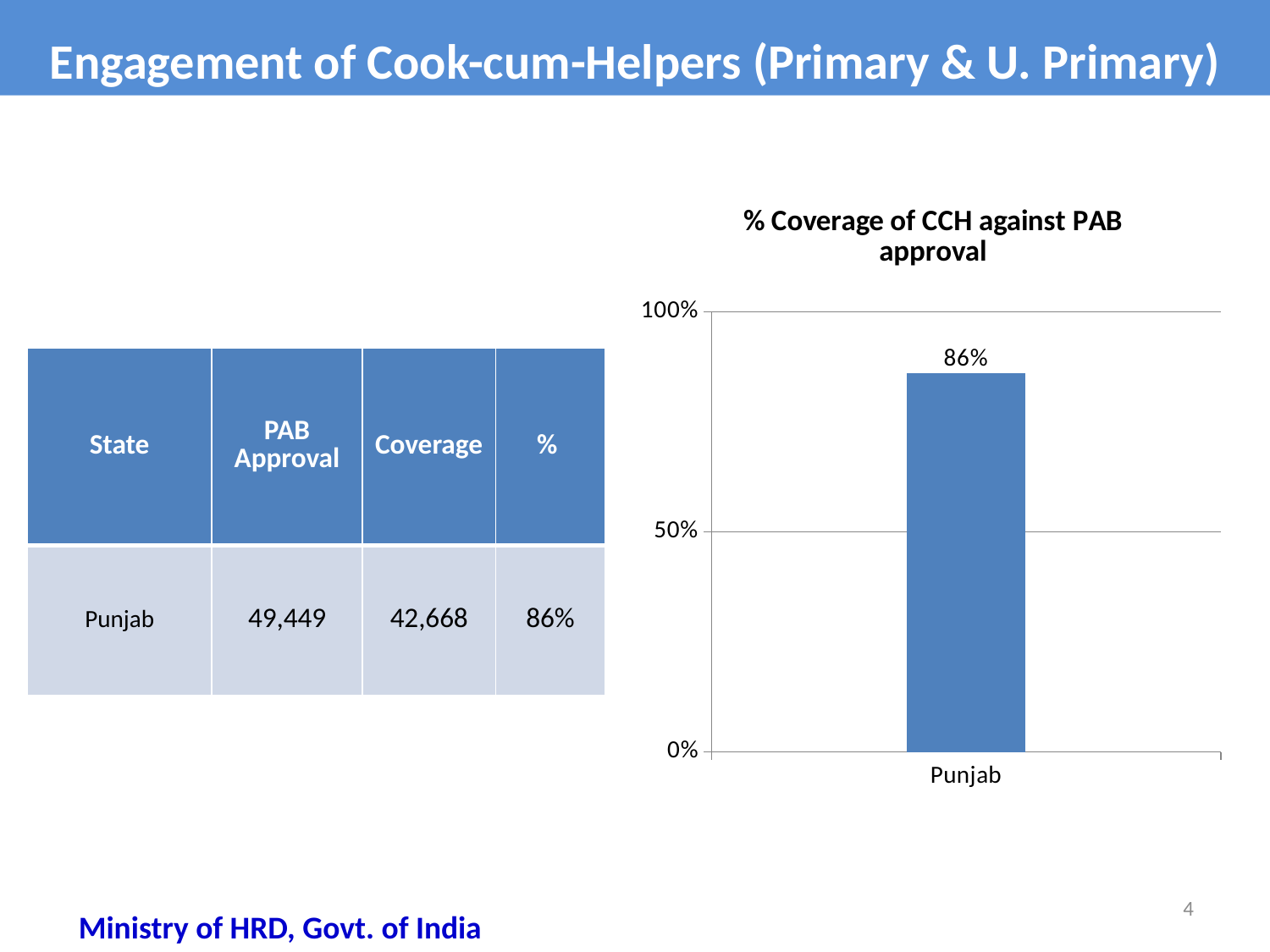
What kind of chart is shown on the slide? bar chart Is the value for Punjab greater or less than 50%? greater Which state is shown on the x axis of the chart? Punjab What is the highest value shown on the chart's y axis? 100% What is the value for Punjab in the chart? 86% How many categories are plotted in the chart? 1 Is the value for Punjab greater or less than 100%? less What is the title of the chart? % Coverage of CCH against PAB approval